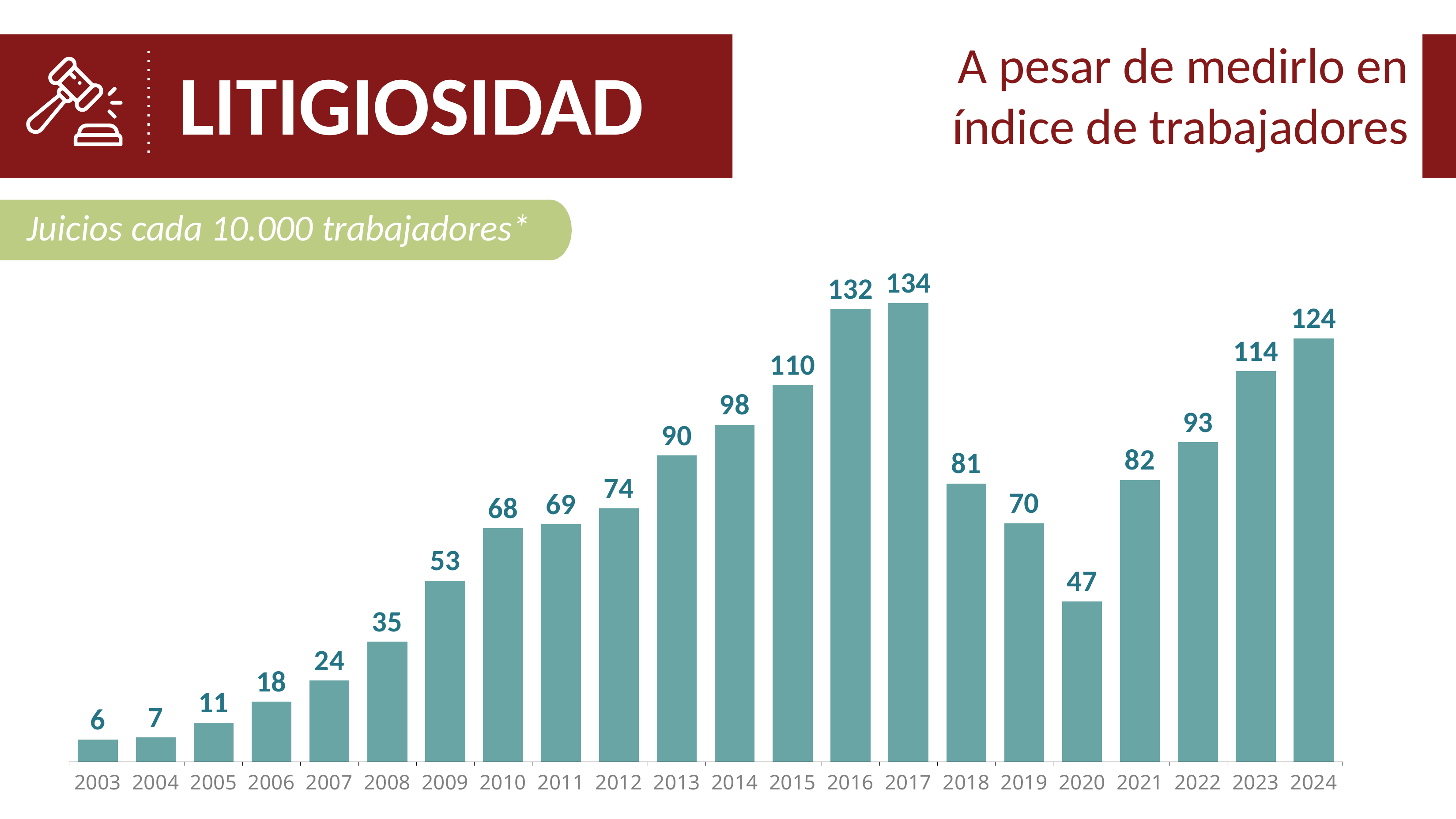
What is the difference between the values for 2024 and 2023? 10 How many years are shown on the x axis? 22 Which year has the highest value? 2017 What is the value for 2017? 134 What is the subtitle label above the chart? Juicios cada 10.000 trabajadores* Which is larger, the value for 2016 or the value for 2024? 2016 What is the difference between the values for 2017 and 2018? 53 What is the value for 2003? 6 What kind of chart is shown on the slide? Bar chart What is the value for 2020? 47 Do the values rise or fall from 2003 to 2017? Rise Which year has the lowest value? 2003